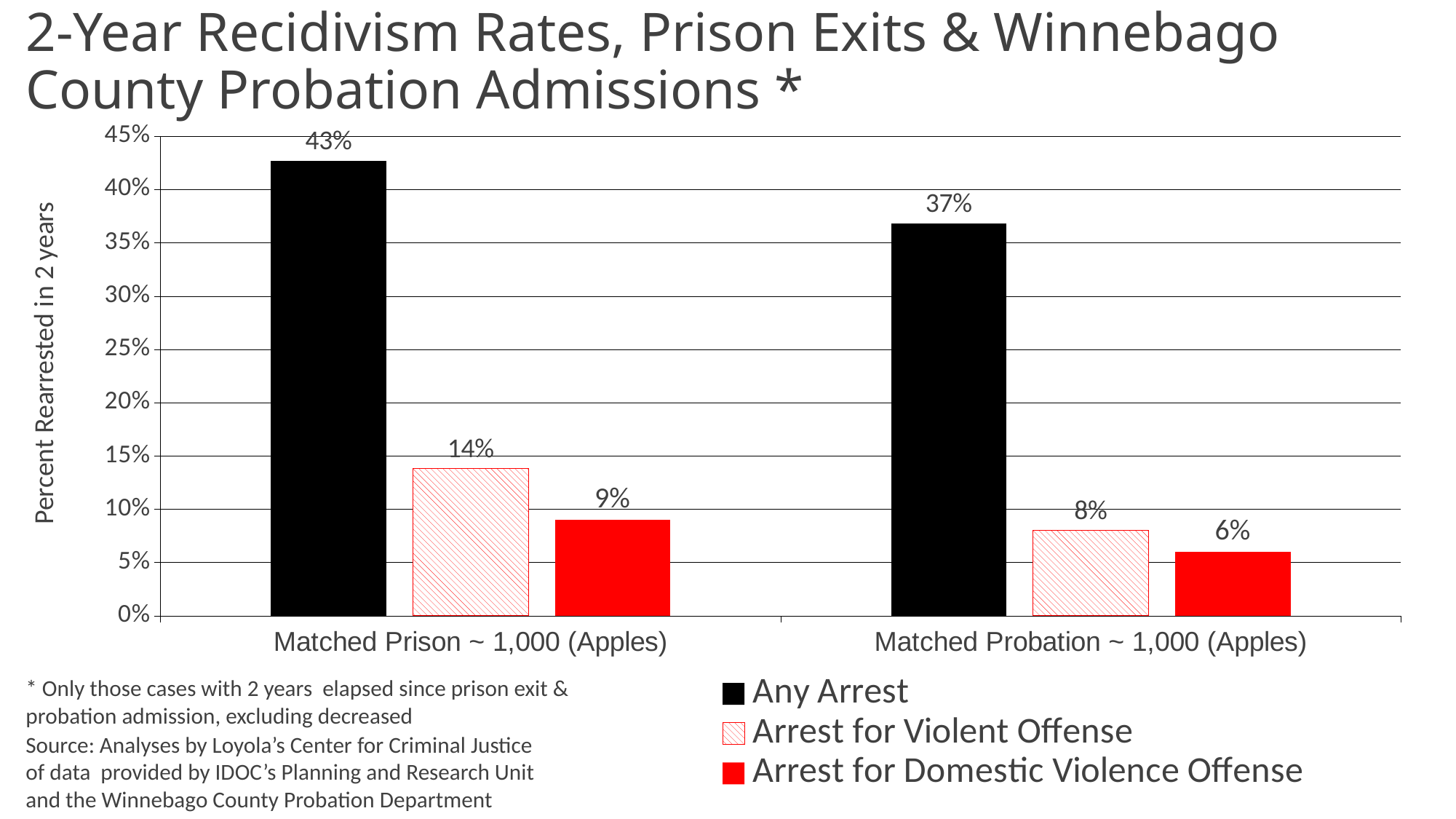
What is the Arrest for Domestic Violence Offense rate for Matched Prison ~ 1,000 (Apples)? 9% What is the Any Arrest rate for Matched Prison ~ 1,000 (Apples)? 43% What is the Any Arrest rate for Matched Probation ~ 1,000 (Apples)? 37% Which is larger: the Arrest for Domestic Violence Offense rate for Matched Prison or for Matched Probation? Matched Prison Which series has the lowest value for Matched Probation ~ 1,000 (Apples)? Arrest for Domestic Violence Offense What kind of chart is shown on the slide? Bar chart What is the label of the y axis? Percent Rearrested in 2 years How many series does the legend list? 3 What is the difference between the Any Arrest rates for Matched Prison and Matched Probation? 6% Which category has the highest Any Arrest rate? Matched Prison ~ 1,000 (Apples) What is the Arrest for Violent Offense rate for Matched Probation ~ 1,000 (Apples)? 8% What is the difference between the Arrest for Violent Offense rates for Matched Prison and Matched Probation? 6%